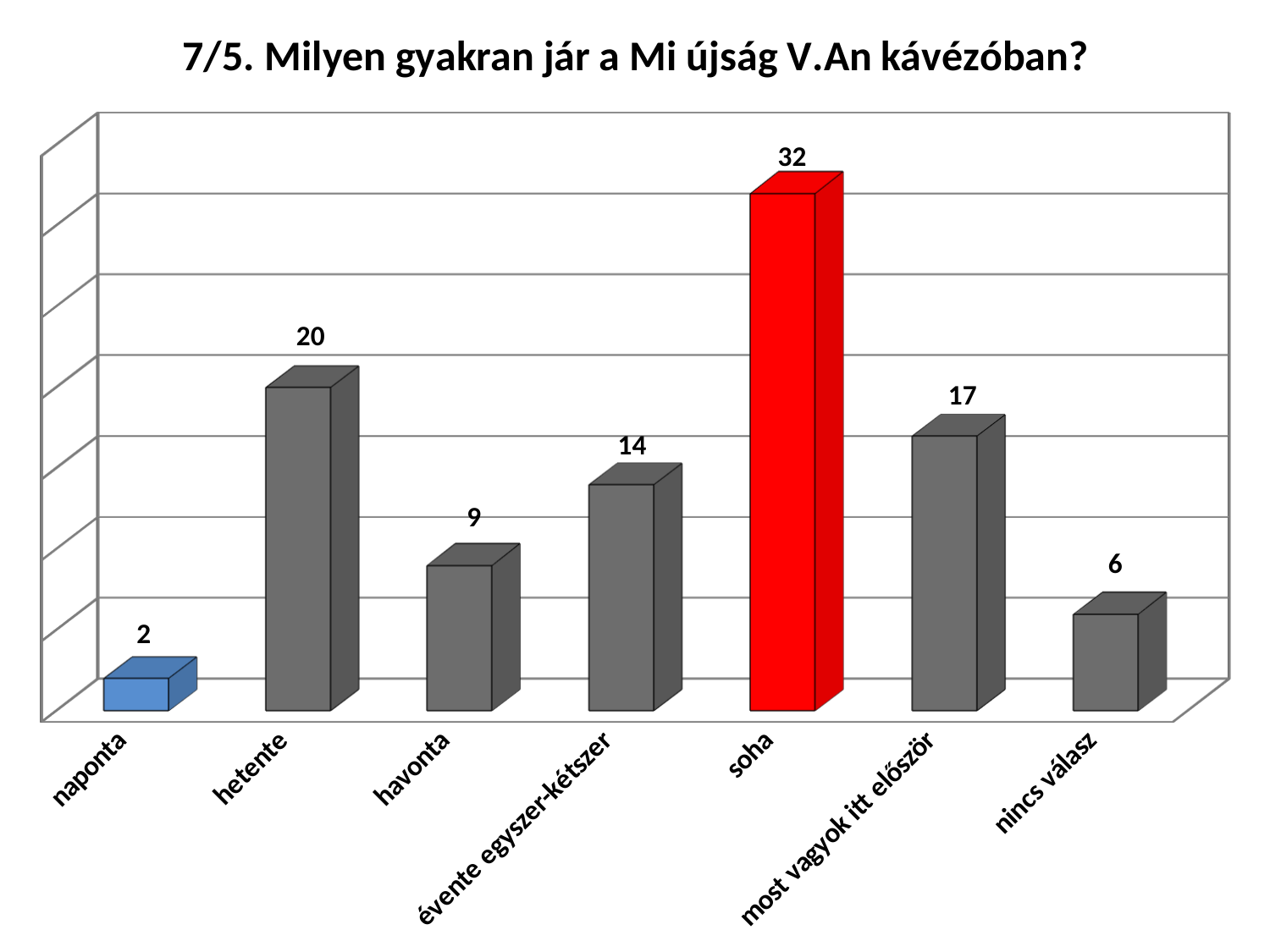
What is the difference between the values for "havonta" and "naponta"? 7 What is the value for "most vagyok itt először"? 17 Which is larger, the value for "hetente" or the value for "most vagyok itt először"? hetente Which category has the highest value? soha What kind of chart is shown on the slide? bar chart What is the title of the chart? 7/5. Milyen gyakran jár a Mi újság V.An kávézóban? What is the value for "hetente"? 20 What is the value for "soha"? 32 Which category has the lowest value? naponta How many categories are shown on the x axis? 7 What is the value for "évente egyszer-kétszer"? 14 What is the difference between the values for "soha" and "hetente"? 12